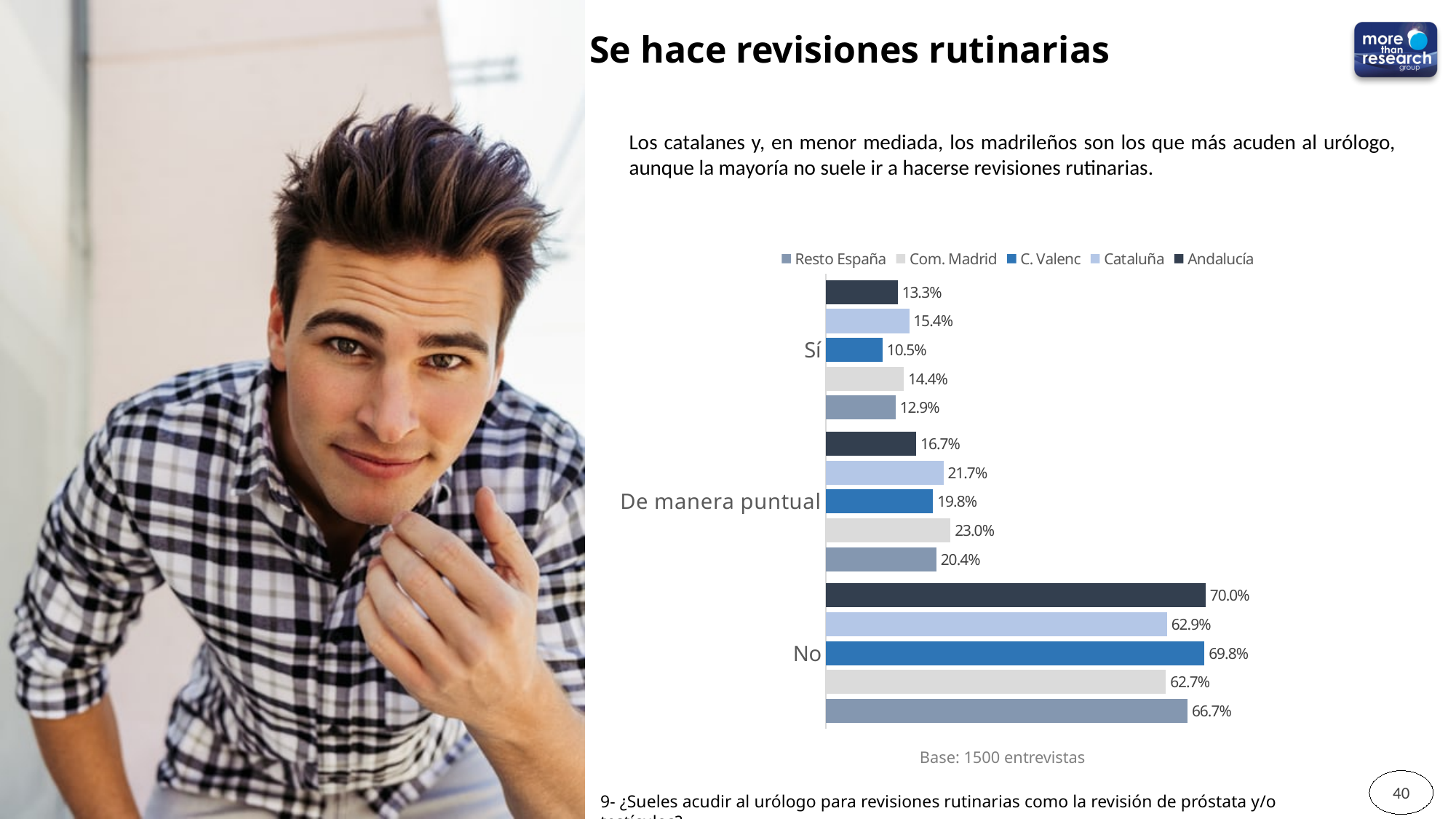
Which region has the highest value in the 'De manera puntual' category? Com. Madrid What is the value for Resto España in the 'No' category? 66.7% What base is stated below the chart? Base: 1500 entrevistas Which region has the lowest value in the 'Sí' category? C. Valenc How many categories are shown on the chart? 3 Which is larger in the 'De manera puntual' category: Cataluña or Andalucía? Cataluña What is the value for Com. Madrid in the 'De manera puntual' category? 23.0% How many series does the legend list? 5 What kind of chart is shown on the slide? Bar chart What is the value for Andalucía in the 'No' category? 70.0% What is the difference between Andalucía and Com. Madrid in the 'No' category? 7.3% What is the value for Cataluña in the 'Sí' category? 15.4%